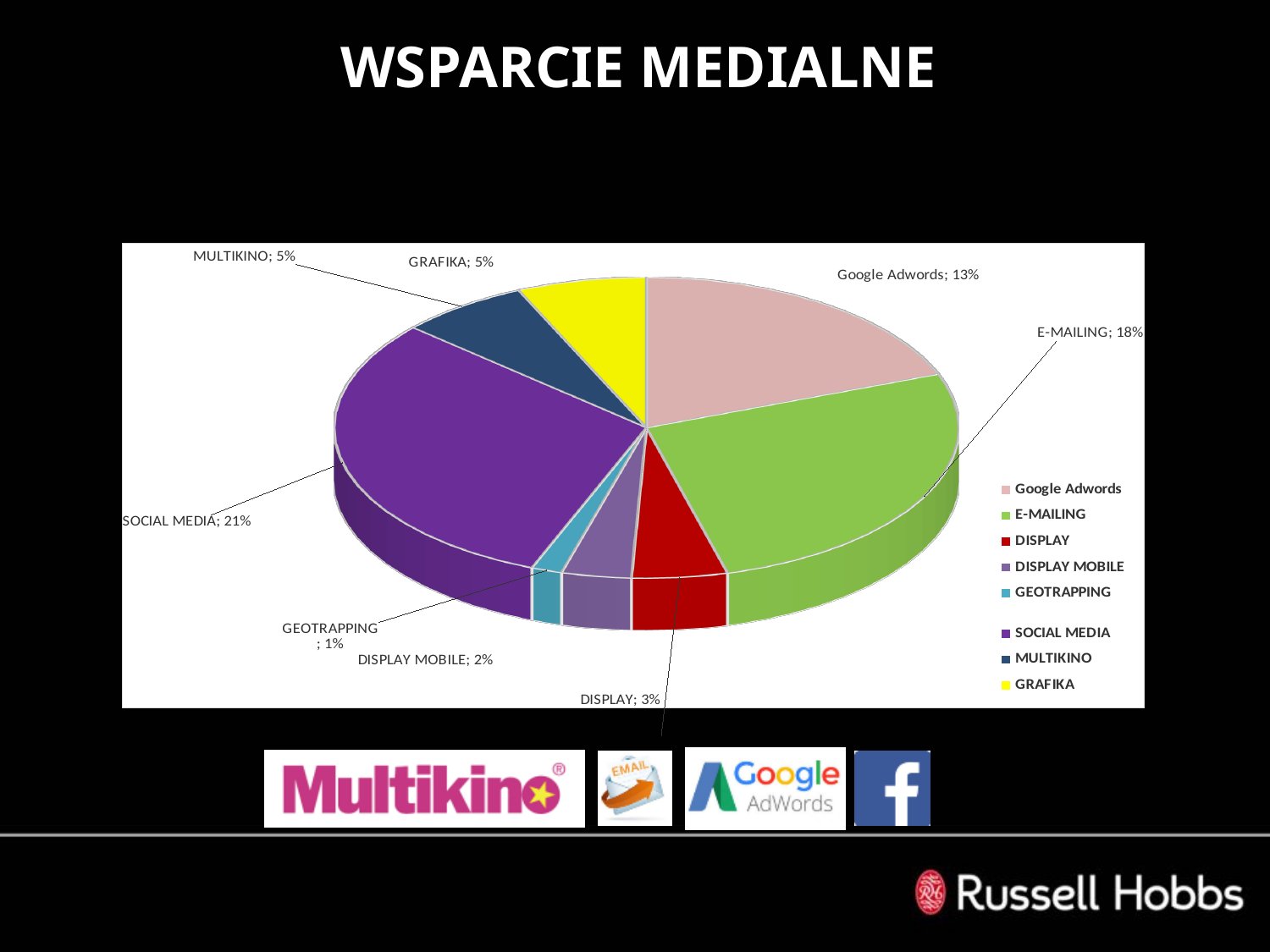
Which category has the largest share of the pie? SOCIAL MEDIA Which has a larger share, Google Adwords or DISPLAY? Google Adwords What kind of chart is shown on the slide? pie chart What share of the pie does Google Adwords have? 13% What share of the pie does GEOTRAPPING have? 1% How many categories does the legend list? 8 Which category has the smallest share of the pie? GEOTRAPPING What share of the pie does SOCIAL MEDIA have? 21% What is the title of the slide containing the chart? WSPARCIE MEDIALNE What is the difference in percentage points between SOCIAL MEDIA and E-MAILING? 3